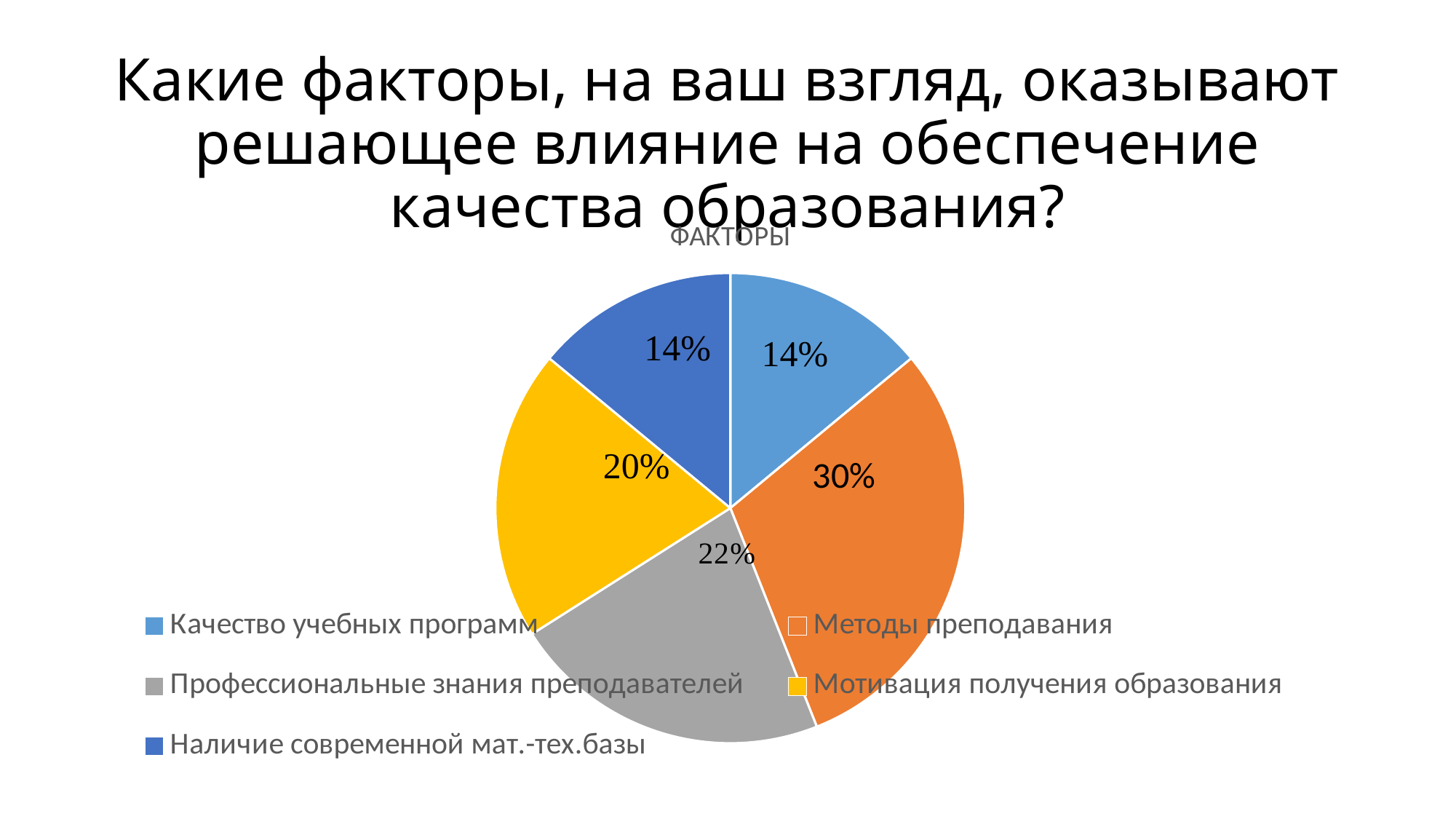
What colour is the slice for 'Мотивация получения образования'? yellow What share of the pie is 'Качество учебных программ'? 14% How many slices does the pie chart have? 5 What share of the pie is 'Методы преподавания'? 30% What is the difference in percentage points between 'Методы преподавания' and 'Профессиональные знания преподавателей'? 8% Which factor has the largest share of the pie? Методы преподавания What share of the pie is 'Профессиональные знания преподавателей'? 22% Which is larger: 'Профессиональные знания преподавателей' or 'Мотивация получения образования'? Профессиональные знания преподавателей What is the title of the chart? ФАКТОРЫ What type of chart is shown on the slide? pie chart What is the difference in percentage points between 'Методы преподавания' and 'Наличие современной мат.-тех.базы'? 16%